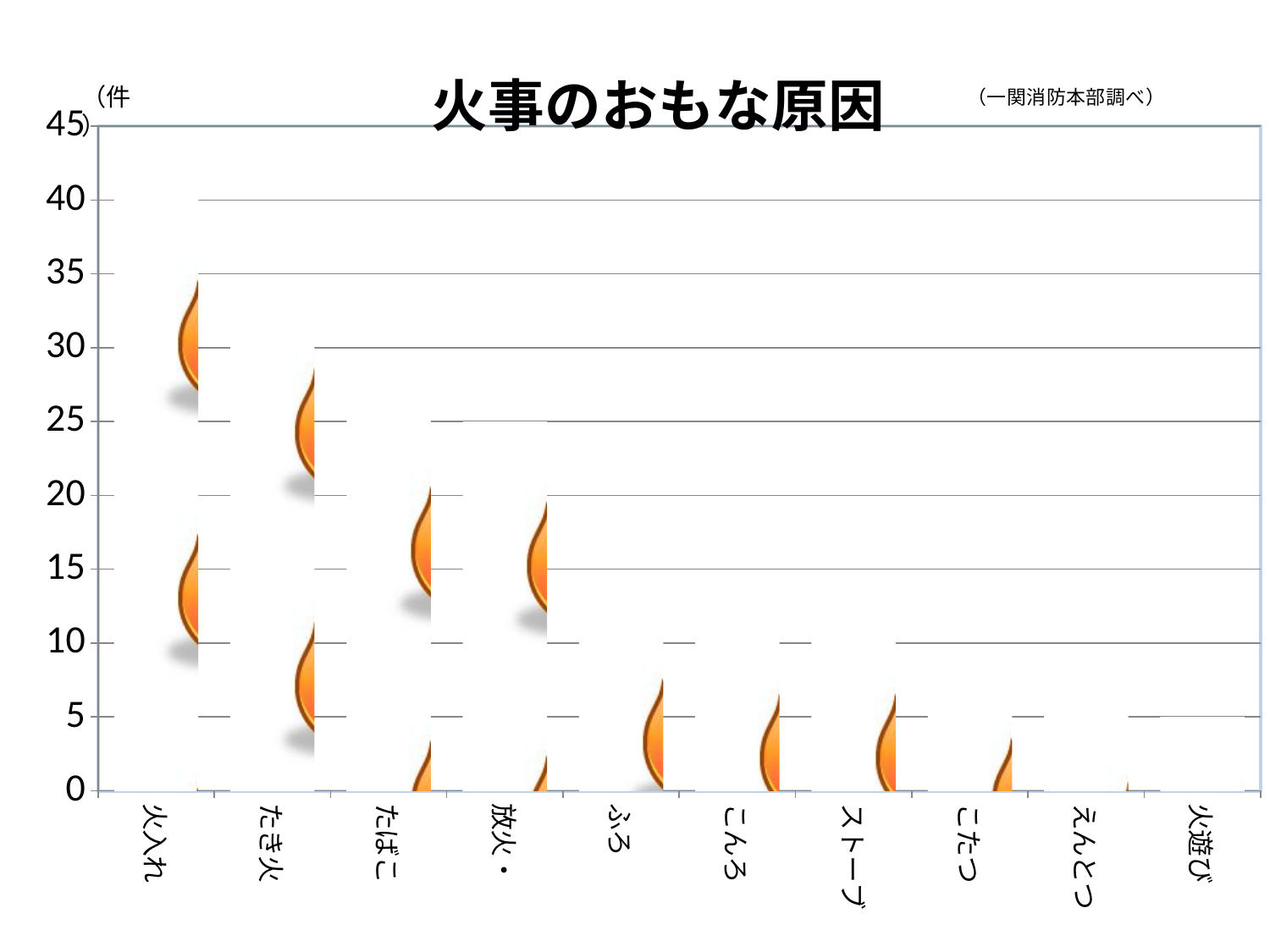
Which cause has the lowest number of fires? 火遊び Is the value for たばこ greater or less than 15? greater Which is larger, the value for 火入れ or the value for たき火? 火入れ What kind of chart is shown on the slide? bar chart What is the title of the chart? 火事のおもな原因 Which cause has the highest number of fires? 火入れ How many categories (causes) are shown on the x axis? 10 Do the values generally rise or fall from left to right along the x axis? fall Is the value for 火入れ greater or less than 30? greater Which is larger, the value for ふろ or the value for こたつ? ふろ